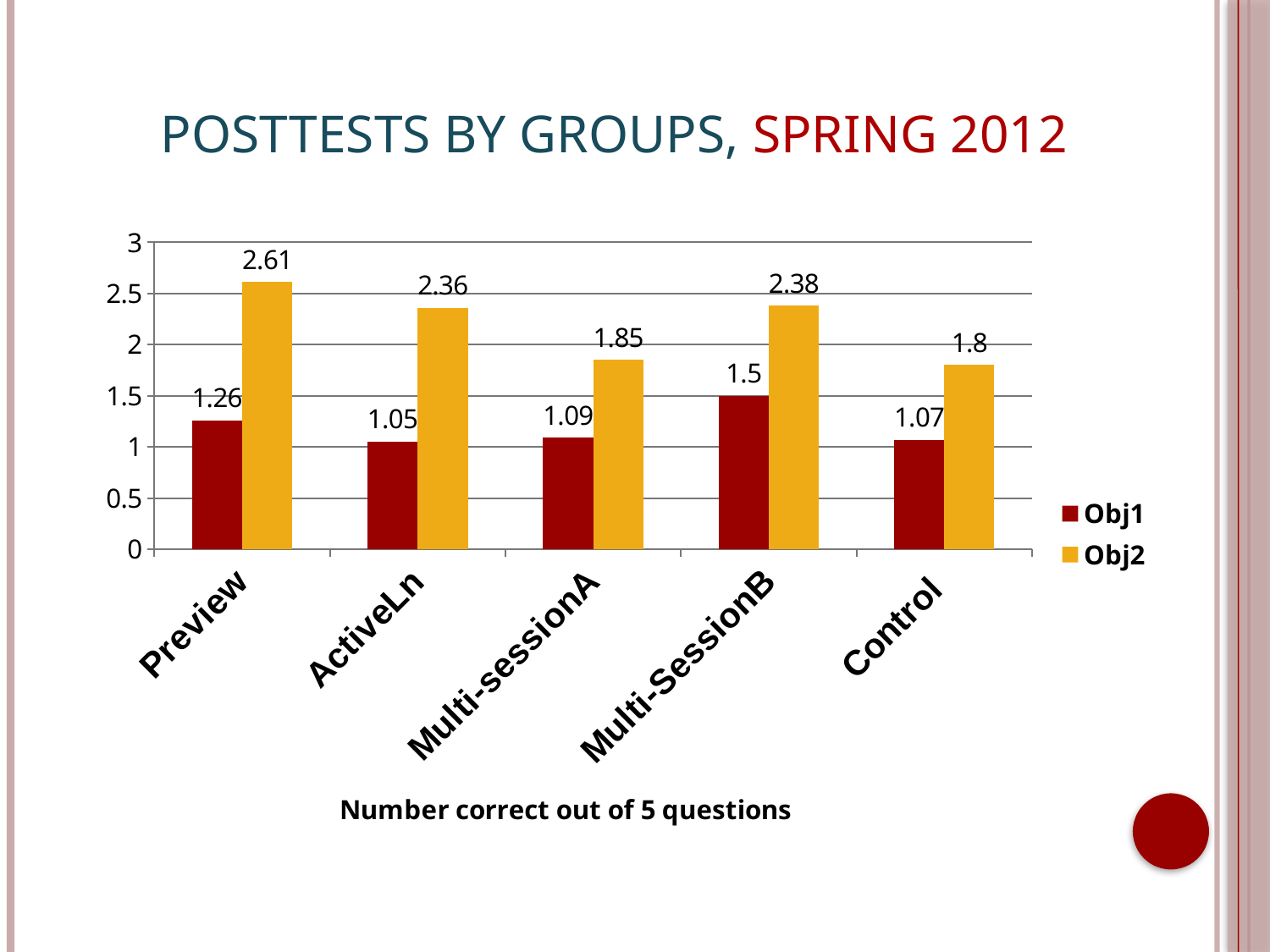
What is the x-axis label below the chart? Number correct out of 5 questions What is the Obj2 value for Multi-SessionB? 2.38 What is the difference between the Obj2 and Obj1 values for Preview? 1.35 What is the Obj2 value for Control? 1.8 Is the Obj1 value for Multi-SessionB greater or less than 1? greater What kind of chart is shown on the slide? bar chart Which is larger, the Obj2 value for ActiveLn or the Obj2 value for Multi-sessionA? ActiveLn How many series does the legend list? 2 What is the Obj1 value for Preview? 1.26 How many groups are shown on the x axis? 5 Which group has the lowest Obj1 value? ActiveLn Which group has the highest Obj2 value? Preview